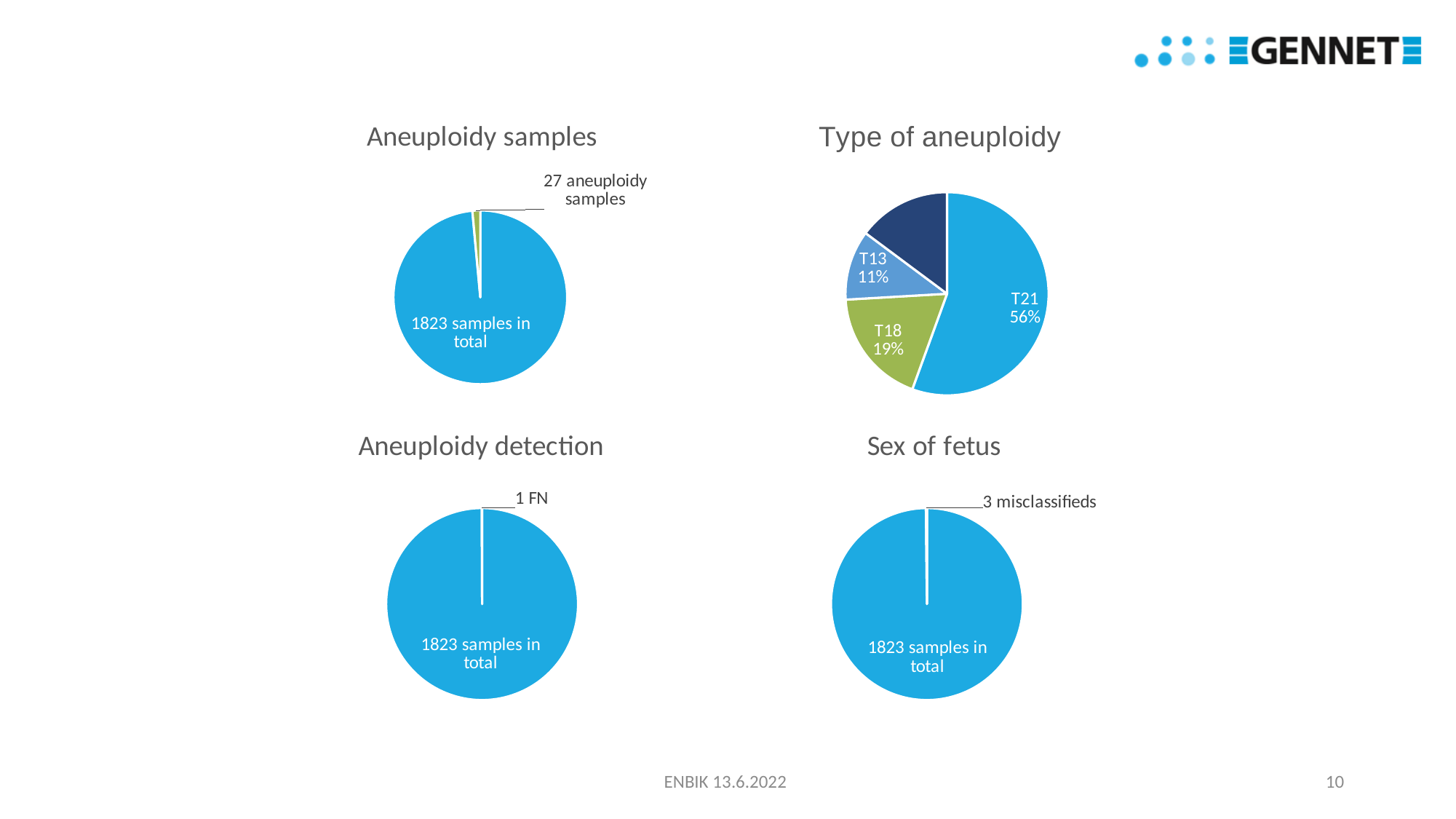
How many slices does the "Type of aneuploidy" pie chart have? 4 In the "Aneuploidy detection" chart, what is the label of the small slice? 1 FN In the "Type of aneuploidy" chart, which labelled type has the smallest share? T13 In the "Type of aneuploidy" chart, what share of the pie is T13? 11% In the "Sex of fetus" chart, how many samples are labelled as misclassified? 3 In the "Type of aneuploidy" chart, which labelled type has the largest share? T21 In the "Type of aneuploidy" chart, what share of the pie is T18? 19% What kind of chart is the "Type of aneuploidy" chart? pie chart In the "Type of aneuploidy" chart, which has a larger share, T18 or T13? T18 In the "Type of aneuploidy" chart, what share of the pie is T21? 56% In the "Aneuploidy samples" chart, how many aneuploidy samples are labelled? 27 In the "Type of aneuploidy" chart, what is the difference in percentage points between the T21 and T18 shares? 37